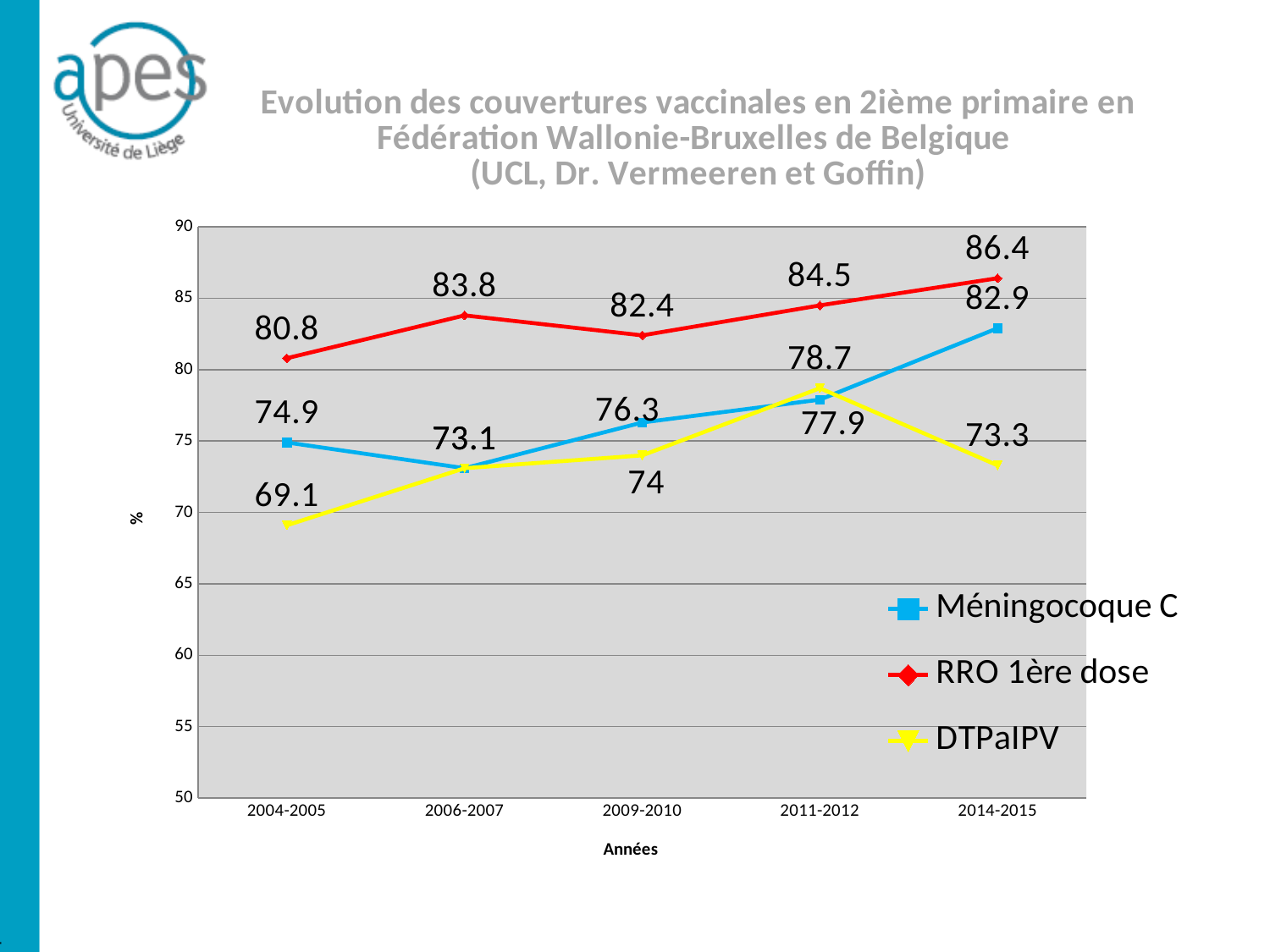
In which period is DTPaIPV at its lowest value? 2004-2005 Does Méningocoque C rise or fall between 2009-2010 and 2014-2015? Rise What is the value for DTPaIPV in 2014-2015? 73.3 How many series does the legend list? 3 What kind of chart is shown on the slide? Line chart What is the value for DTPaIPV in 2004-2005? 69.1 In which period does RRO 1ère dose reach its highest value? 2014-2015 What is the value for Méningocoque C in 2004-2005? 74.9 What is the value for RRO 1ère dose in 2014-2015? 86.4 In 2011-2012, which is higher: DTPaIPV or Méningocoque C? DTPaIPV How many periods are shown on the x axis? 5 By how much did RRO 1ère dose increase from 2004-2005 to 2014-2015? 5.6